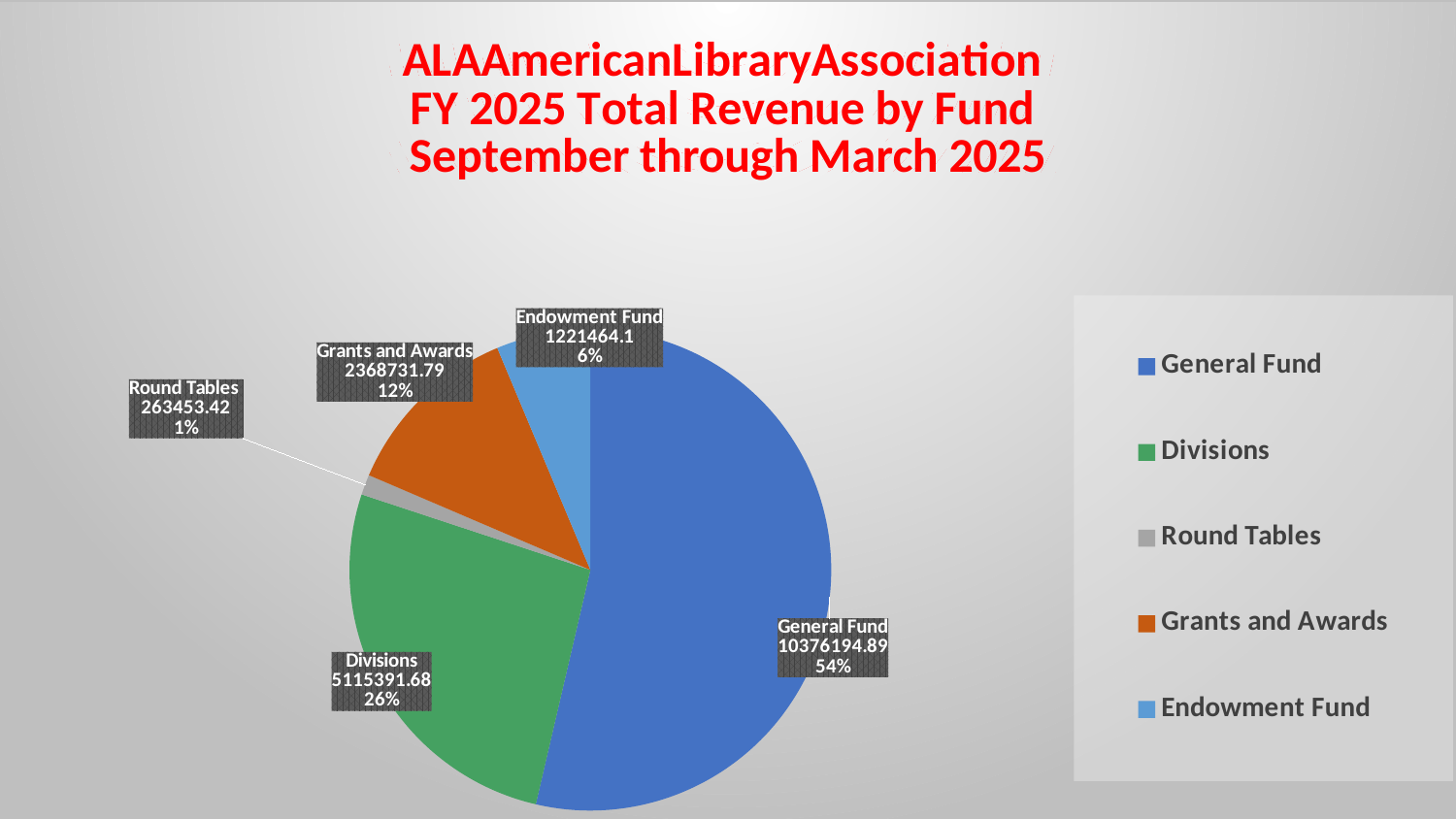
What percentage share of total revenue does the General Fund slice represent? 54% Which fund has the smallest share of revenue? Round Tables What is the revenue value for the General Fund? 10376194.89 What type of chart is shown on the slide? pie chart What is the difference in revenue between the General Fund and Divisions? 5260803.21 What is the revenue value for Divisions? 5115391.68 What is the revenue value for Grants and Awards? 2368731.79 Which fund has the largest share of revenue? General Fund What is the revenue value for the Endowment Fund? 1221464.1 What percentage share of total revenue does the Round Tables slice represent? 1% How many funds are shown in the pie chart? 5 Which has a larger revenue value, Grants and Awards or the Endowment Fund? Grants and Awards